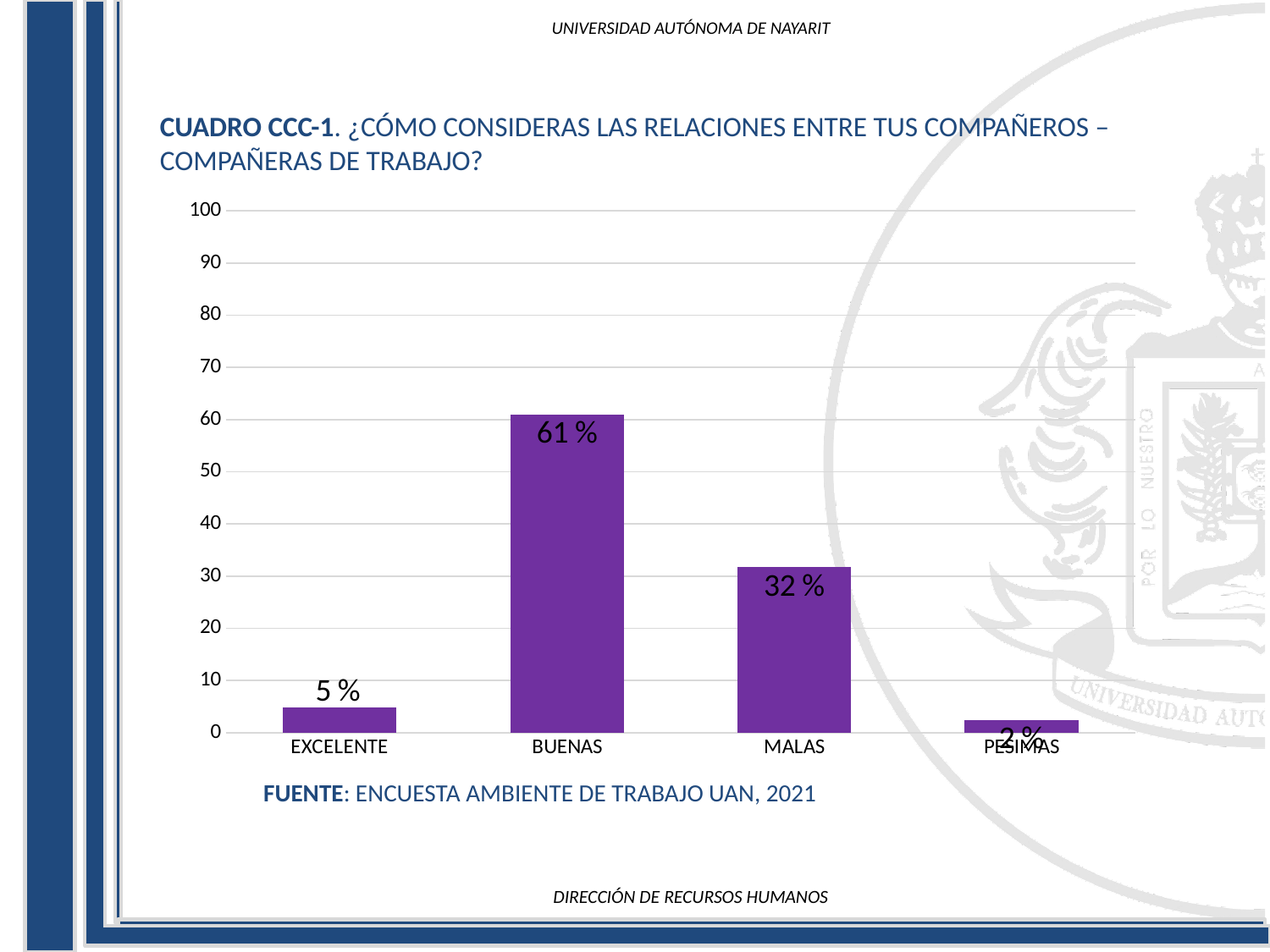
What is the difference between the values for BUENAS and MALAS? 29 % What is the value for BUENAS? 61 % What is the value for MALAS? 32 % Which category has the highest value? BUENAS Which category has the lowest value? PESIMAS Which is larger, the value for MALAS or the value for EXCELENTE? MALAS Is the value for BUENAS greater or less than 50? greater What is the value for EXCELENTE? 5 % What kind of chart is shown on the slide? bar chart What source is cited below the chart? ENCUESTA AMBIENTE DE TRABAJO UAN, 2021 What is the difference between the values for EXCELENTE and PÉSIMAS? 3 % How many categories are shown on the x axis? 4